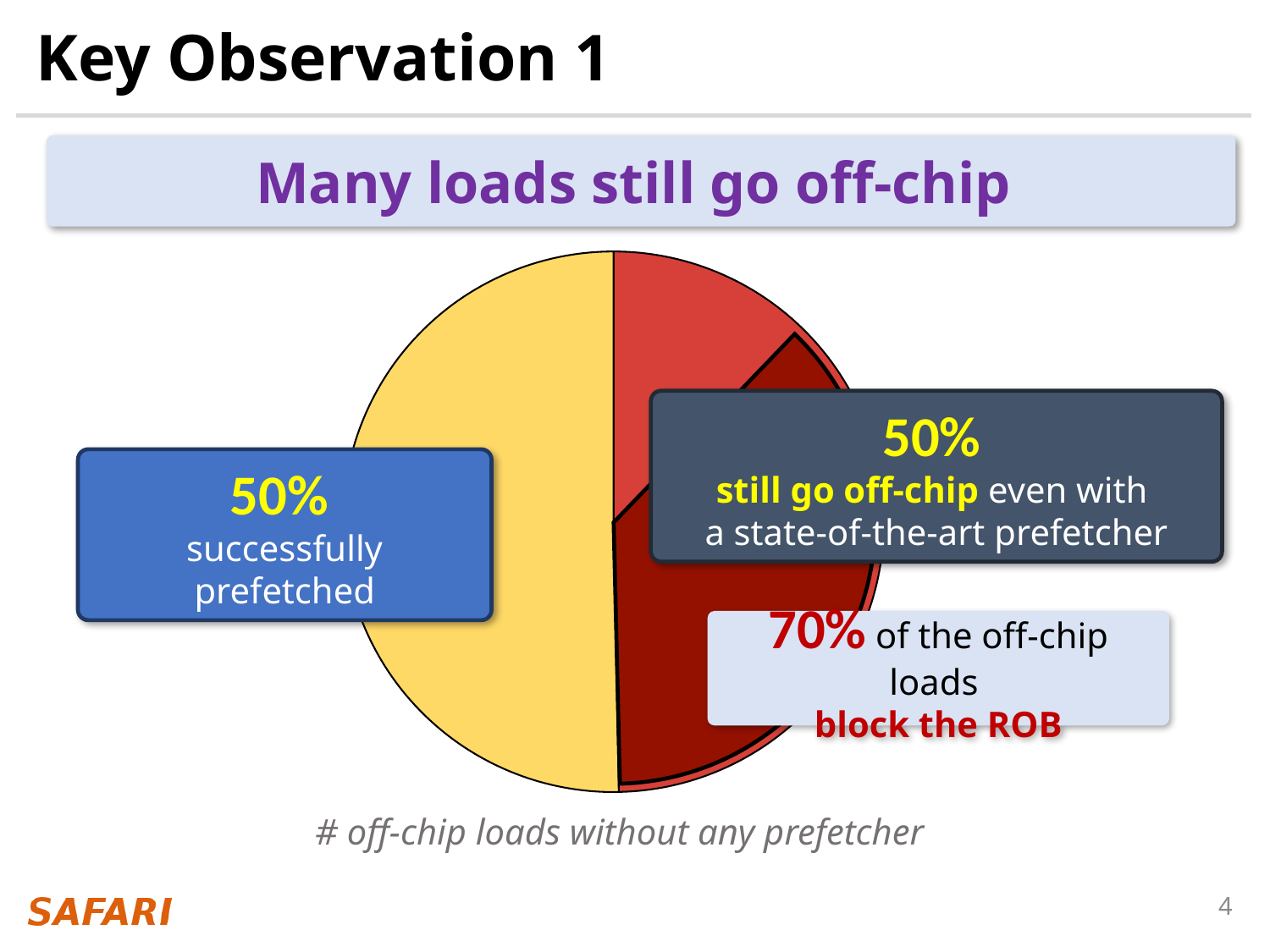
What share of loads still go off-chip even with a state-of-the-art prefetcher? 50% What does the pie chart represent, according to the caption below it? # off-chip loads without any prefetcher What is the total of the successfully prefetched share and the still-go-off-chip share? 100% Is the share of off-chip loads that block the ROB greater or less than 50%? greater What colour is the slice representing loads that were successfully prefetched? yellow What kind of chart is shown on the slide? pie chart What is the difference between the share successfully prefetched and the share that still go off-chip? 0% What percentage of the off-chip loads block the ROB? 70% What share of off-chip loads is successfully prefetched according to the pie chart? 50% Is the share of loads successfully prefetched larger or smaller than the share that still go off-chip? equal